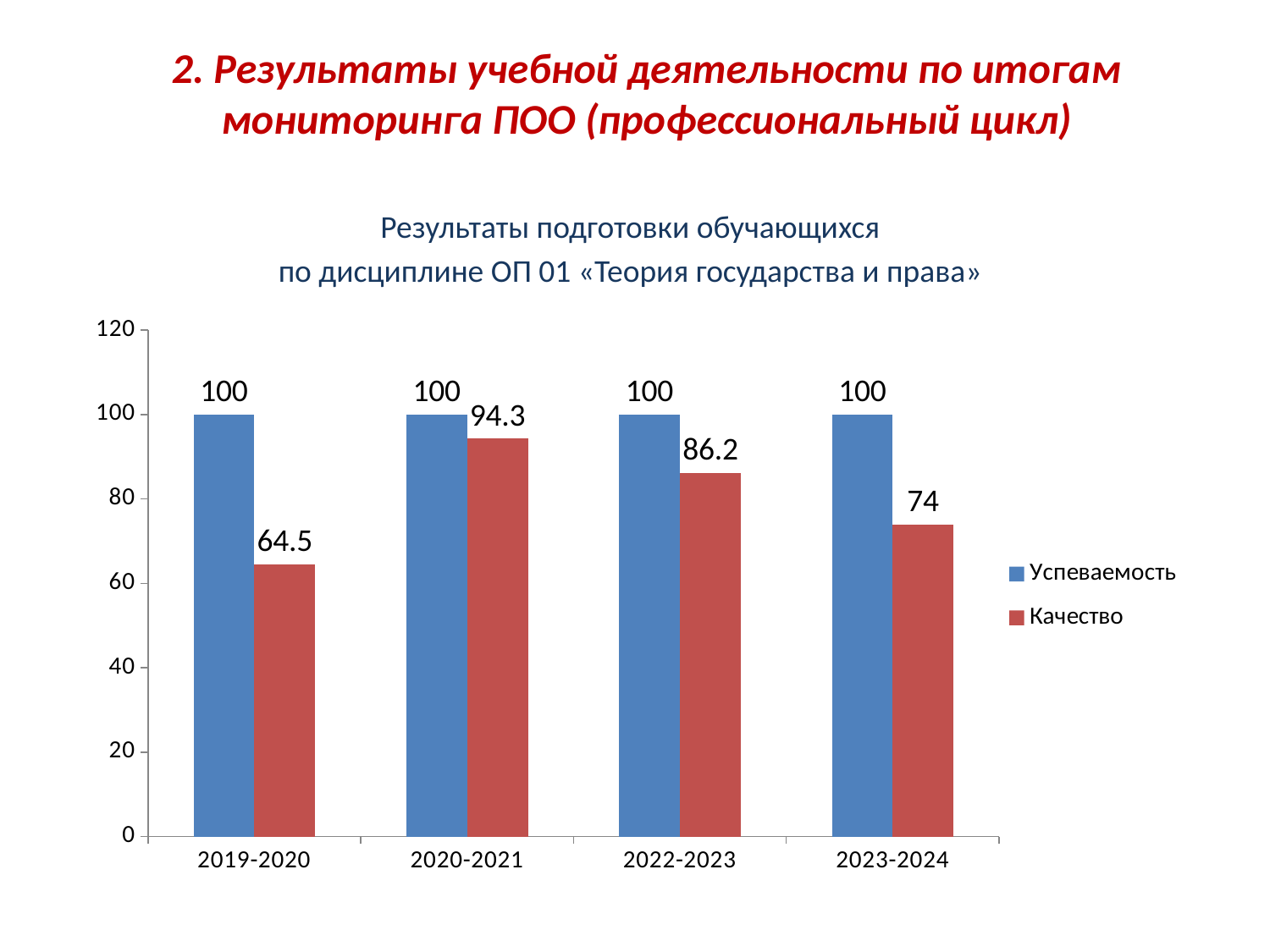
What is the value of Качество for 2019-2020? 64.5 Which is larger: Качество in 2020-2021 or Качество in 2023-2024? 2020-2021 How many series does the legend list? 2 What kind of chart is shown? bar chart What is the value of Качество for 2023-2024? 74 What is the difference between Успеваемость and Качество in 2022-2023? 13.8 In which year is Качество highest? 2020-2021 What is the value of Успеваемость for 2022-2023? 100 What is the value of Качество for 2020-2021? 94.3 Which series is shown in red? Качество How many academic years are shown on the x axis? 4 In which year is Качество lowest? 2019-2020